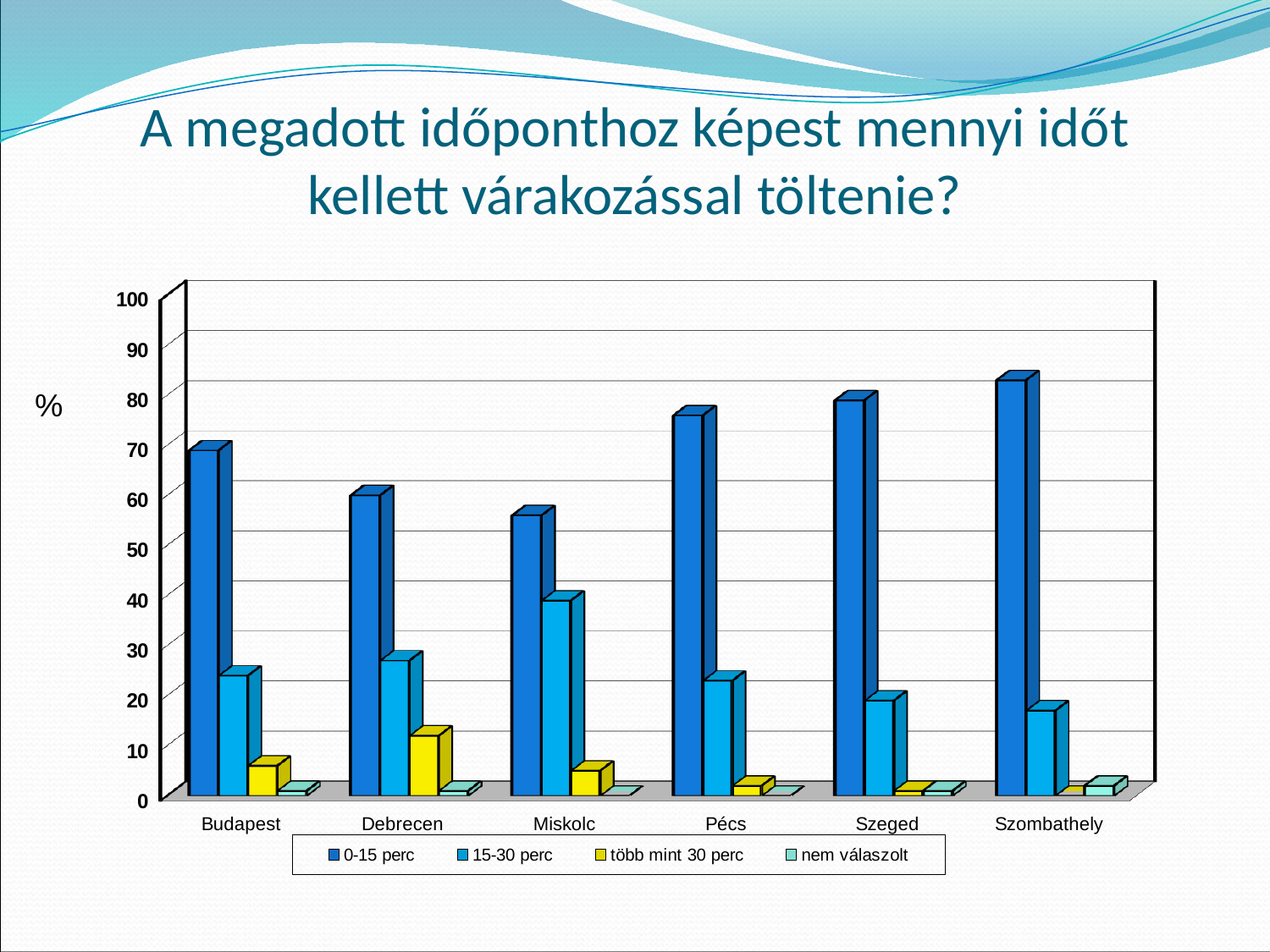
What unit label is shown next to the vertical axis of the chart? % Is the 0-15 perc value for Budapest greater or less than 60? greater Which city has the highest value for the 0-15 perc series? Szombathely Which city has the highest value for the 15-30 perc series? Miskolc Which is larger: the 0-15 perc value for Pécs or the 0-15 perc value for Debrecen? Pécs How many series does the chart's legend list? 4 Is the 15-30 perc value for Szombathely greater or less than 20? less Is the 0-15 perc value for Miskolc greater or less than 60? less How many cities are shown on the x axis of the chart? 6 What kind of chart is shown on the slide? bar chart Which city has the highest value for the több mint 30 perc series? Debrecen Which city has the lowest value for the 0-15 perc series? Miskolc